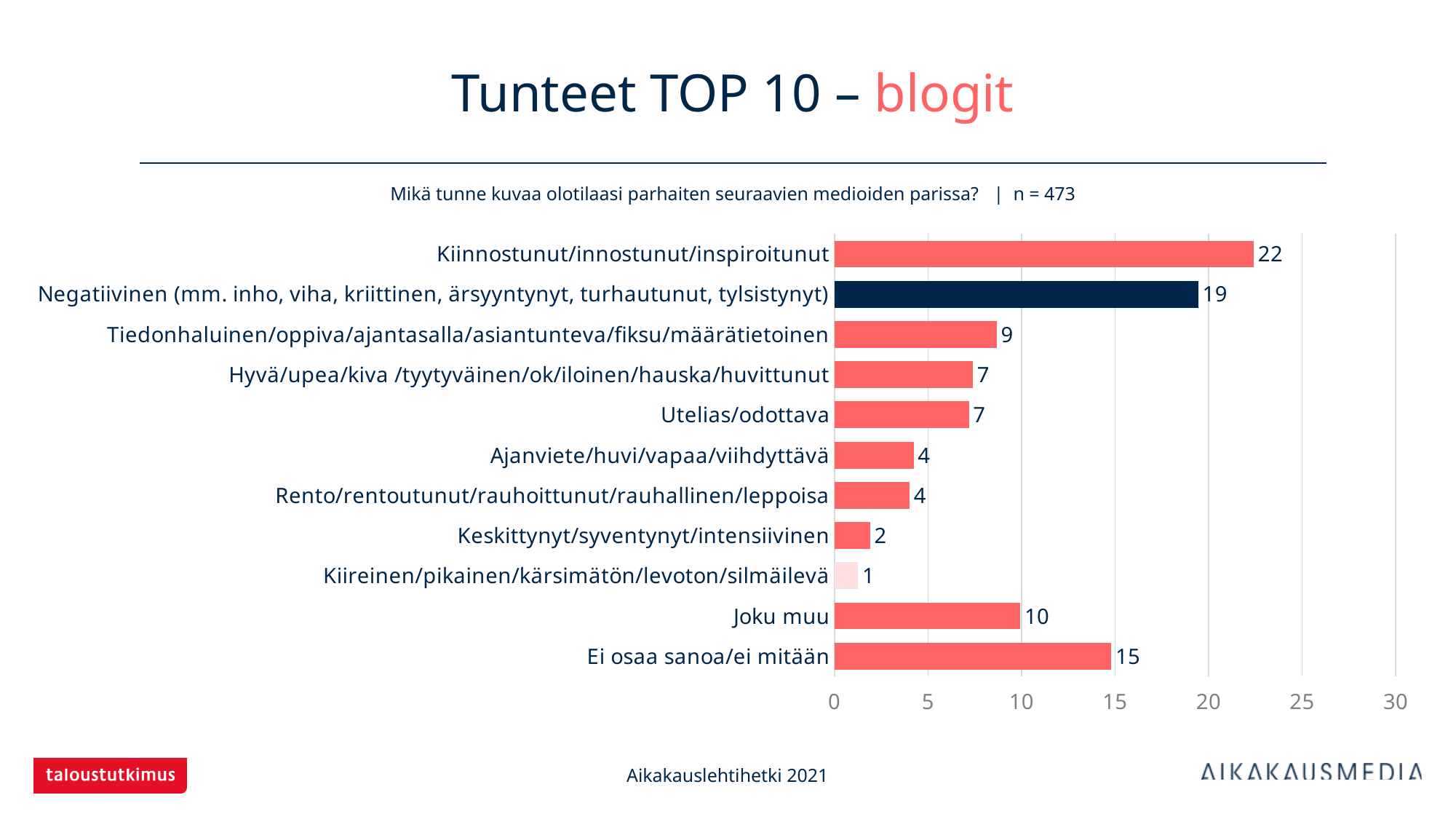
Which is larger, the value for Tiedonhaluinen/oppiva/ajantasalla/asiantunteva/fiksu/määrätietoinen or the value for Joku muu? Joku muu What kind of chart is shown on the slide? bar chart Which category has the lowest value? Kiireinen/pikainen/kärsimätön/levoton/silmäilevä Which category has the highest value? Kiinnostunut/innostunut/inspiroitunut What is the sample size (n) stated on the slide? 473 What is the value for Kiinnostunut/innostunut/inspiroitunut? 22 Is the value for Ei osaa sanoa/ei mitään greater or less than 20? less What is the value for Joku muu? 10 What is the value for Ei osaa sanoa/ei mitään? 15 What is the value for Negatiivinen (mm. inho, viha, kriittinen, ärsyyntynyt, turhautunut, tylsistynyt)? 19 How many categories are shown in the chart? 11 What is the difference between the values for Kiinnostunut/innostunut/inspiroitunut and Negatiivinen (mm. inho, viha, kriittinen, ärsyyntynyt, turhautunut, tylsistynyt)? 3